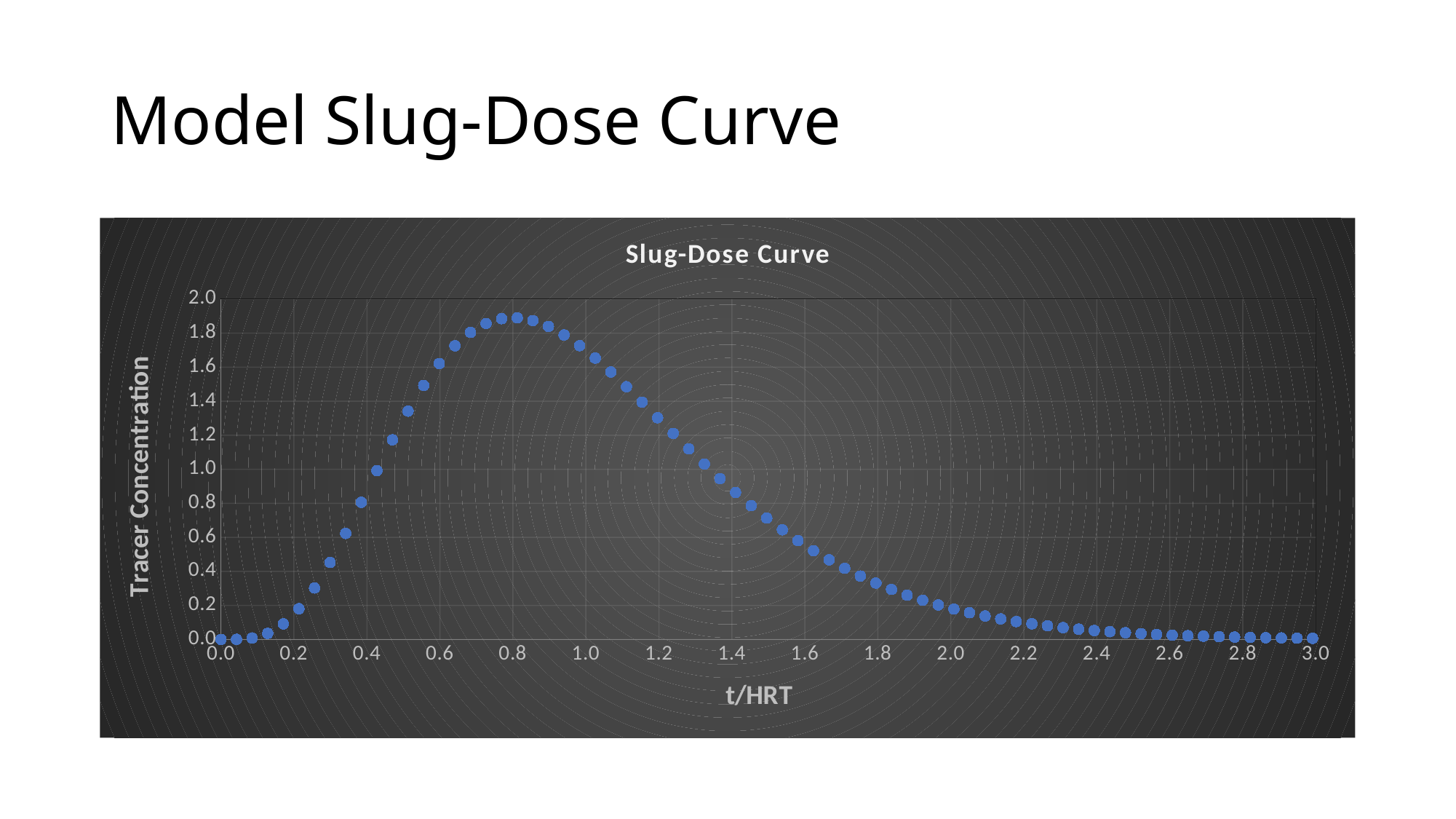
What is the label of the x axis? t/HRT What kind of chart is shown on the slide? scatter chart Which has the higher tracer concentration, t/HRT = 0.6 or t/HRT = 1.6? t/HRT = 0.6 What is the tracer concentration at t/HRT = 0.0? 0.0 Which has the higher tracer concentration, t/HRT = 1.0 or t/HRT = 2.0? t/HRT = 1.0 Is the tracer concentration at t/HRT = 2.0 greater or less than 0.4? less Is the tracer concentration at t/HRT = 0.8 greater or less than 1.8? greater Is the tracer concentration at t/HRT = 1.6 greater or less than 0.8? less How does the tracer concentration change as t/HRT increases from 1.0 to 3.0? it falls What is the title of the chart? Slug-Dose Curve